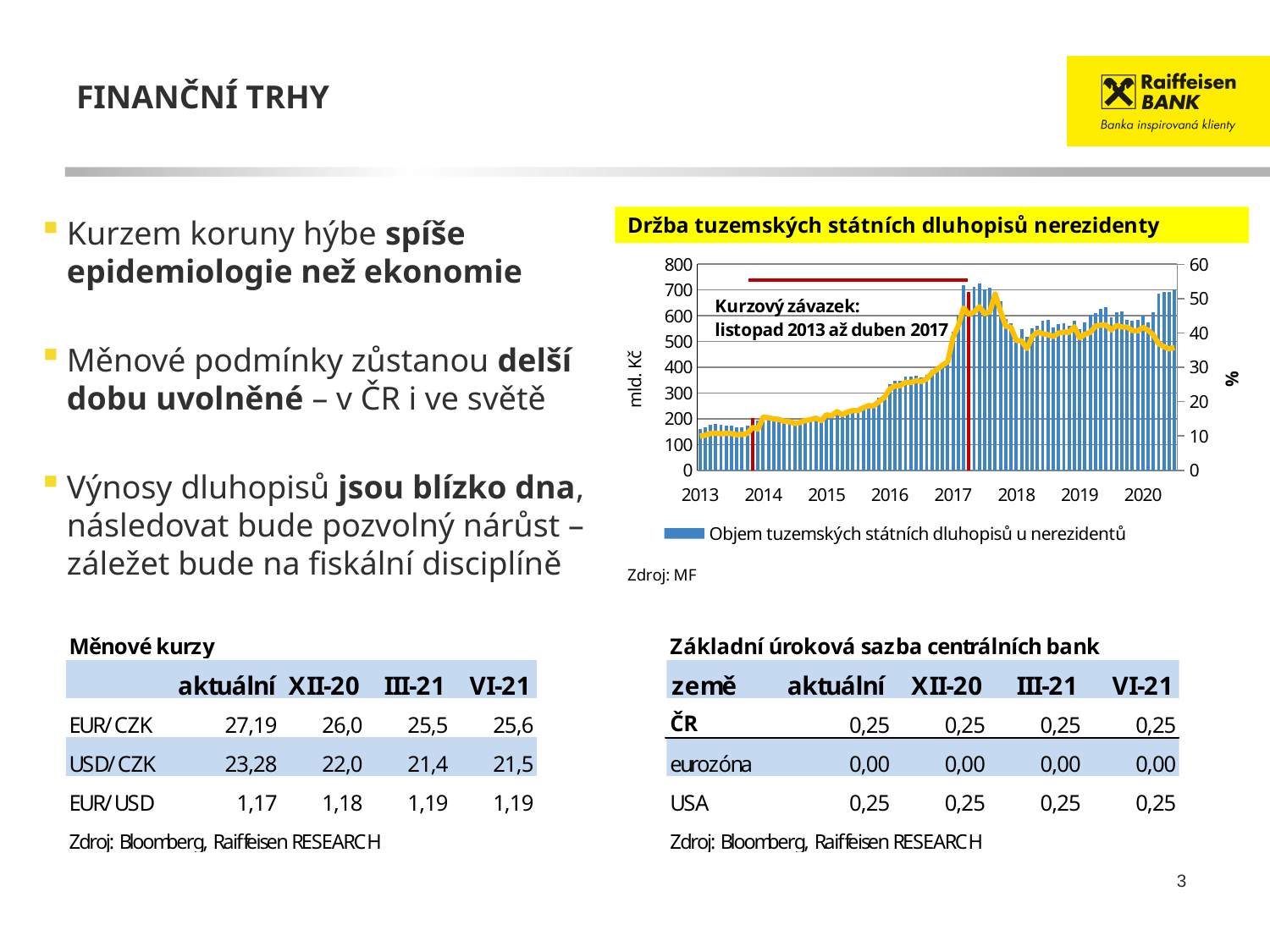
Do the bar values rise or fall from 2013 to 2017? rise What is the title of the chart on the slide? Držba tuzemských státních dluhopisů nerezidenty What unit is shown on the left vertical axis of the chart? mld. Kč What kind of chart is shown under the title 'Držba tuzemských státních dluhopisů nerezidenty'? Bar chart with a line overlay Is the line value (right axis, %) at the start of 2013 greater or less than 20? less Is the peak of the line in 2017 greater or less than 40 on the right axis? greater How many year labels are shown on the x axis of the chart? 8 Is the highest bar in 2017 greater or less than 600 mld. Kč? greater How many series does the chart's legend list? 1 What period does the annotation 'Kurzový závazek' in the chart cover? listopad 2013 až duben 2017